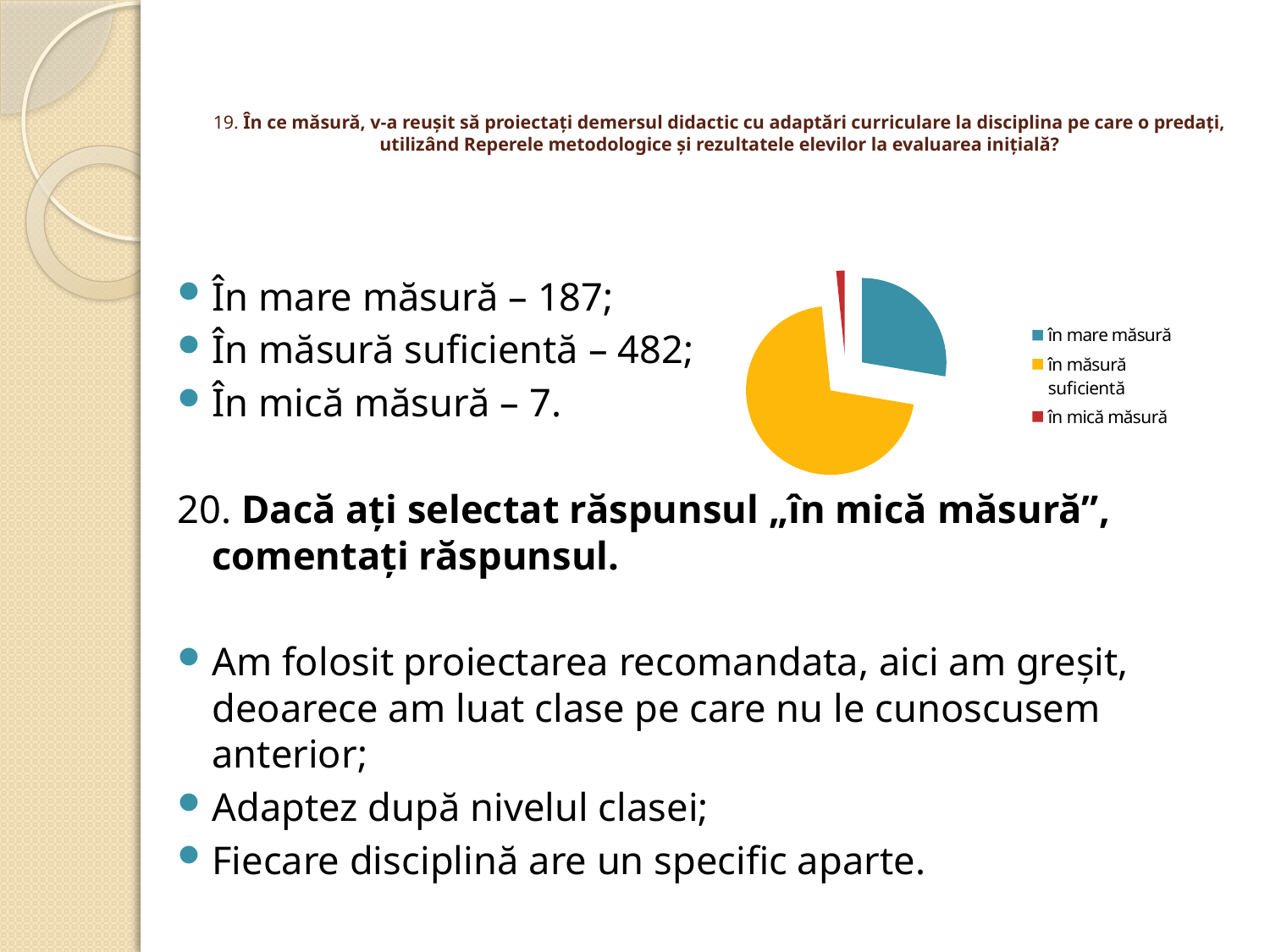
Which category has the largest slice in the pie chart? în măsură suficientă What is the total of the three values shown for the pie chart? 676 What colour is the slice for "în mare măsură" in the pie chart? teal (blue-green) What kind of chart is shown on the slide? pie chart Which is larger: the value for "În mare măsură" or the value for "În măsură suficientă"? În măsură suficientă According to the slide, what is the value for "În mică măsură"? 7 According to the slide, what is the value for "În mare măsură"? 187 What is the difference between the values for "În măsură suficientă" and "În mare măsură"? 295 How many entries does the legend of the pie chart list? 3 According to the slide, what is the value for "În măsură suficientă"? 482 Which category has the smallest slice in the pie chart? în mică măsură How many slices does the pie chart have? 3